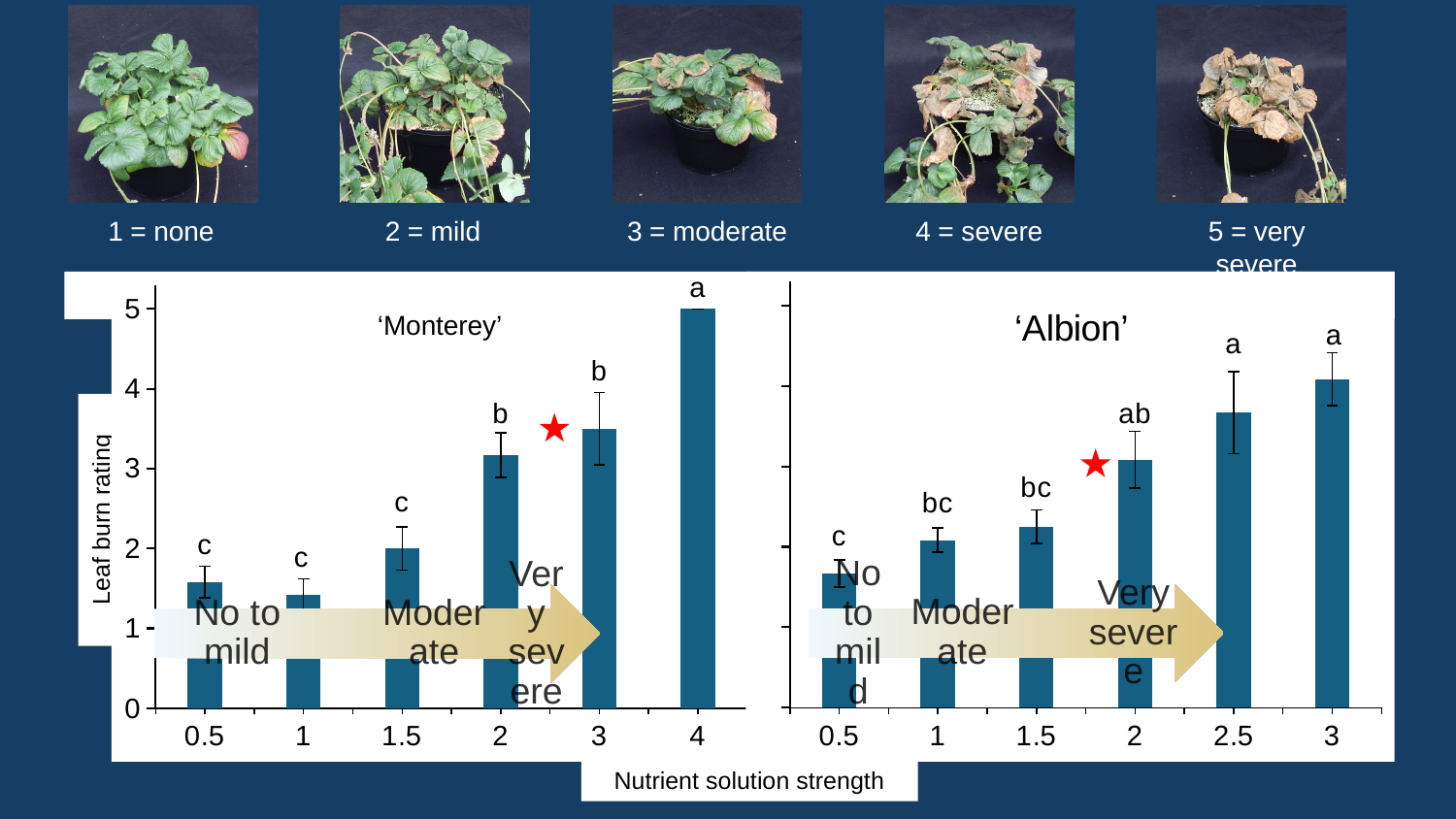
In the 'Monterey' chart, is the leaf burn rating at nutrient solution strength 2 greater or less than 3? greater In the 'Albion' chart, which nutrient solution strength has the lowest leaf burn rating? 0.5 In the 'Monterey' chart, what is the leaf burn rating at nutrient solution strength 4? 5 In the 'Albion' chart, is the leaf burn rating at nutrient solution strength 0.5 greater or less than 2? less What is the label on the shared x axis of the two charts? Nutrient solution strength In the 'Albion' chart, do leaf burn ratings generally rise or fall as nutrient solution strength increases? rise In the 'Albion' chart, how many bars are plotted? 6 In the 'Monterey' chart, how many nutrient solution strength categories are plotted? 6 What kind of chart is the 'Monterey' chart? bar chart In the 'Albion' chart, which nutrient solution strength has the highest leaf burn rating? 3 In the 'Monterey' chart, which nutrient solution strength has the highest leaf burn rating? 4 In the 'Monterey' chart, which has the larger leaf burn rating: nutrient solution strength 1.5 or 3? 3